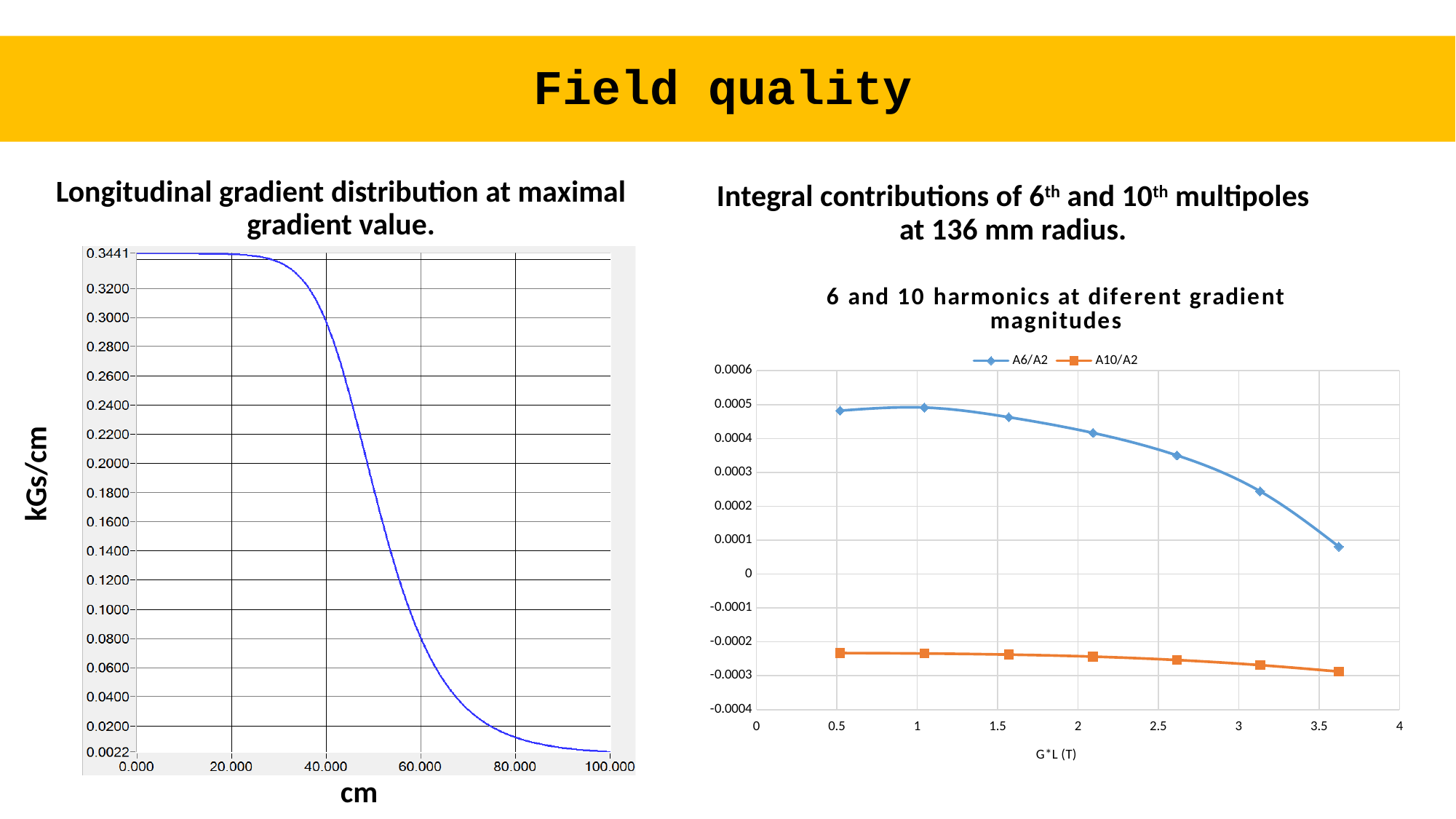
How many series does the legend list in the right chart '6 and 10 harmonics at diferent gradient magnitudes'? 2 In the left chart 'Longitudinal gradient distribution at maximal gradient value', is the value at 40.000 cm greater or less than 0.2000? greater In the right chart '6 and 10 harmonics at diferent gradient magnitudes', is the A6/A2 value at G*L = 0.5 greater or less than 0.0004? greater In the right chart '6 and 10 harmonics at diferent gradient magnitudes', does the A6/A2 series rise or fall as G*L increases? fall In the left chart 'Longitudinal gradient distribution at maximal gradient value', what is the highest value shown on the y axis, where the curve starts? 0.3441 In the left chart 'Longitudinal gradient distribution at maximal gradient value', what is the lowest value shown on the y axis, where the curve ends at 100.000 cm? 0.0022 What kind of chart is the 'Longitudinal gradient distribution at maximal gradient value' chart on the left? line chart In the left chart 'Longitudinal gradient distribution at maximal gradient value', what unit is shown on the y axis? kGs/cm In the left chart 'Longitudinal gradient distribution at maximal gradient value', does the gradient rise or fall as the position in cm increases? fall How many data points does the A6/A2 series have in the right chart '6 and 10 harmonics at diferent gradient magnitudes'? 7 In the right chart '6 and 10 harmonics at diferent gradient magnitudes', is the A10/A2 value at G*L = 0.5 greater or less than -0.0003? greater In the right chart '6 and 10 harmonics at diferent gradient magnitudes', which series has the larger value at G*L = 2, A6/A2 or A10/A2? A6/A2